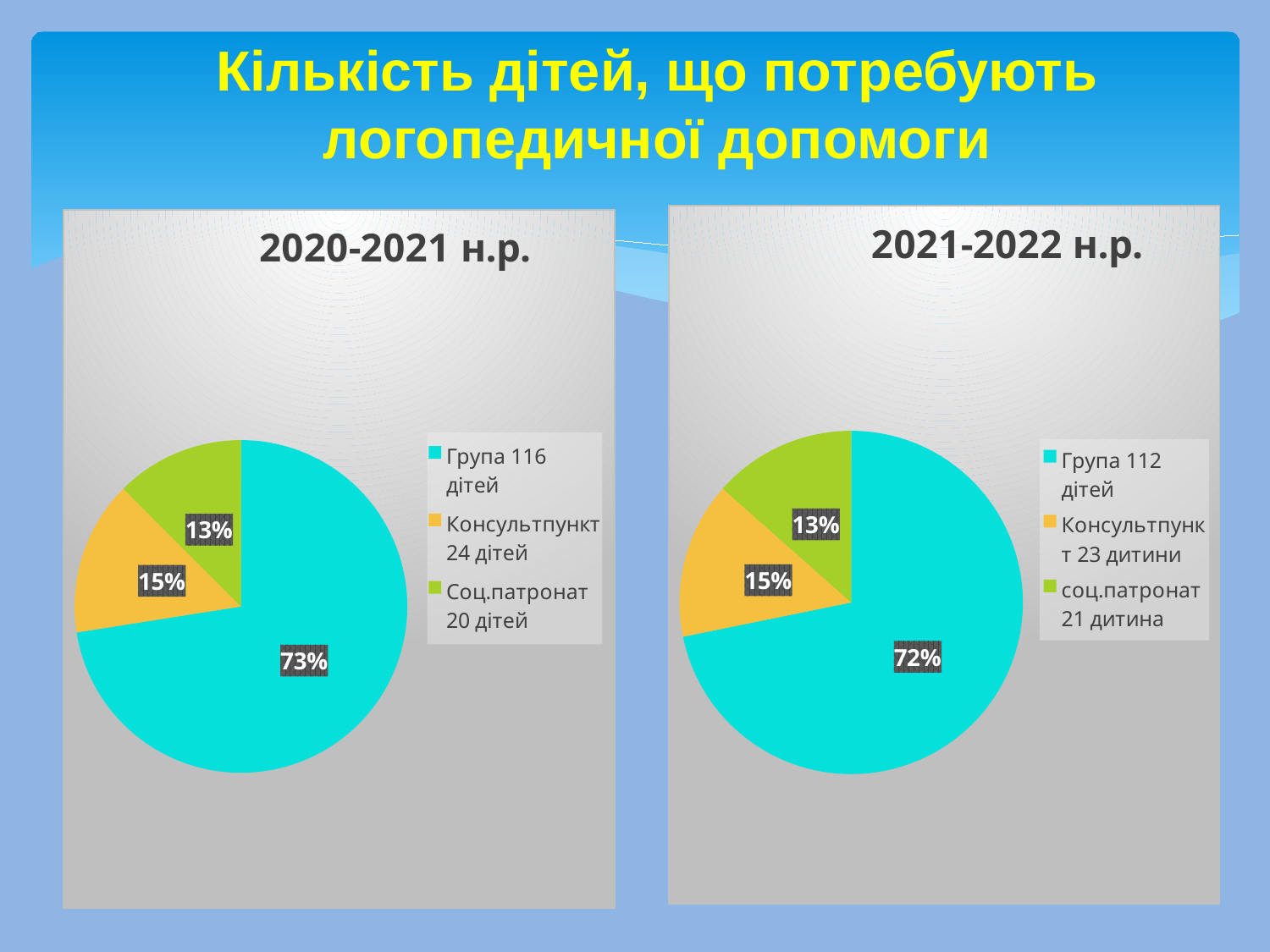
In the 2021-2022 н.р. chart, which slice is larger: Консультпункт or соц.патронат? Консультпункт What is the title of the slide containing the two pie charts? Кількість дітей, що потребують логопедичної допомоги In the 2021-2022 н.р. chart, what percentage is shown for соц.патронат? 13% In the 2020-2021 н.р. chart, what percentage is shown for Консультпункт? 15% What type of chart is used for 2021-2022 н.р.? Pie chart In the 2021-2022 н.р. chart, which category has the smallest slice? соц.патронат 21 дитина How many slices does the 2020-2021 н.р. pie chart have? 3 In the 2020-2021 н.р. chart, which category has the largest slice? Група 116 дітей In the 2020-2021 н.р. chart, what is the difference in percentage points between the Група slice and the Консультпункт slice? 58 percentage points In the 2020-2021 н.р. chart, what share of the pie does the Група slice take? 73% In the 2021-2022 н.р. chart, what share of the pie does the Група slice take? 72% How many entries does the legend of the 2021-2022 н.р. chart list? 3